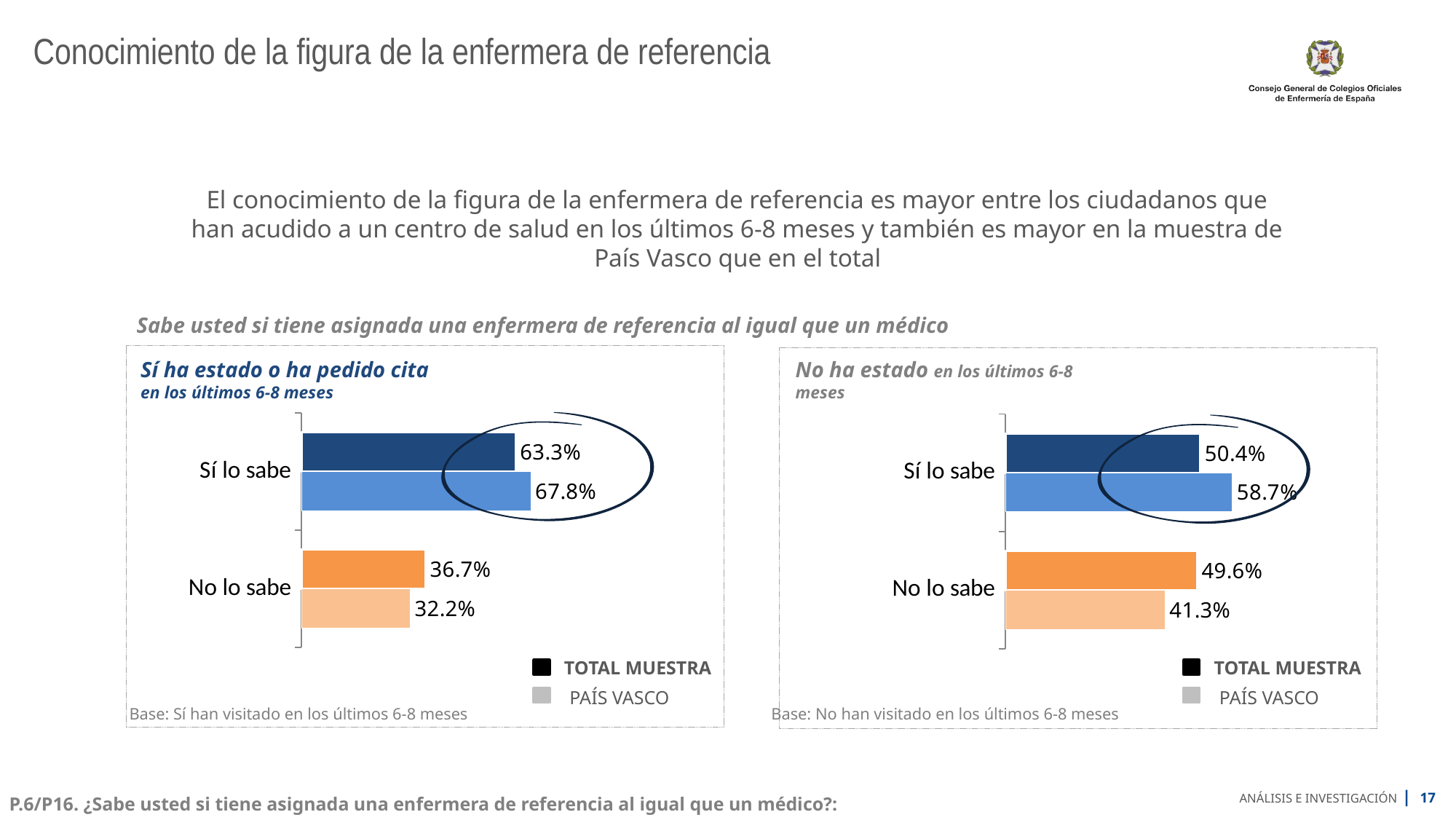
In the left chart ('Sí ha estado o ha pedido cita'), which bar has the highest value? PAÍS VASCO, Sí lo sabe (67.8%) In the left chart ('Sí ha estado o ha pedido cita'), what is the TOTAL MUESTRA value for 'Sí lo sabe'? 63.3% How many series does the legend of the right chart ('No ha estado en los últimos 6-8 meses') list? 2 In the left chart ('Sí ha estado o ha pedido cita'), what is the difference between the PAÍS VASCO and TOTAL MUESTRA values for 'Sí lo sabe'? 4.5% In the right chart ('No ha estado en los últimos 6-8 meses'), which is larger for 'Sí lo sabe': TOTAL MUESTRA or PAÍS VASCO? PAÍS VASCO In the right chart ('No ha estado en los últimos 6-8 meses'), what is the difference between the TOTAL MUESTRA and PAÍS VASCO values for 'No lo sabe'? 8.3% What type of chart is the right chart ('No ha estado en los últimos 6-8 meses')? Bar chart In the right chart ('No ha estado en los últimos 6-8 meses'), what is the PAÍS VASCO value for 'Sí lo sabe'? 58.7% In the right chart ('No ha estado en los últimos 6-8 meses'), what is the TOTAL MUESTRA value for 'No lo sabe'? 49.6% In the left chart ('Sí ha estado o ha pedido cita'), which series has the lowest value for 'No lo sabe'? PAÍS VASCO How many categories are shown in the left chart ('Sí ha estado o ha pedido cita')? 2 In the left chart ('Sí ha estado o ha pedido cita'), what is the PAÍS VASCO value for 'Sí lo sabe'? 67.8%